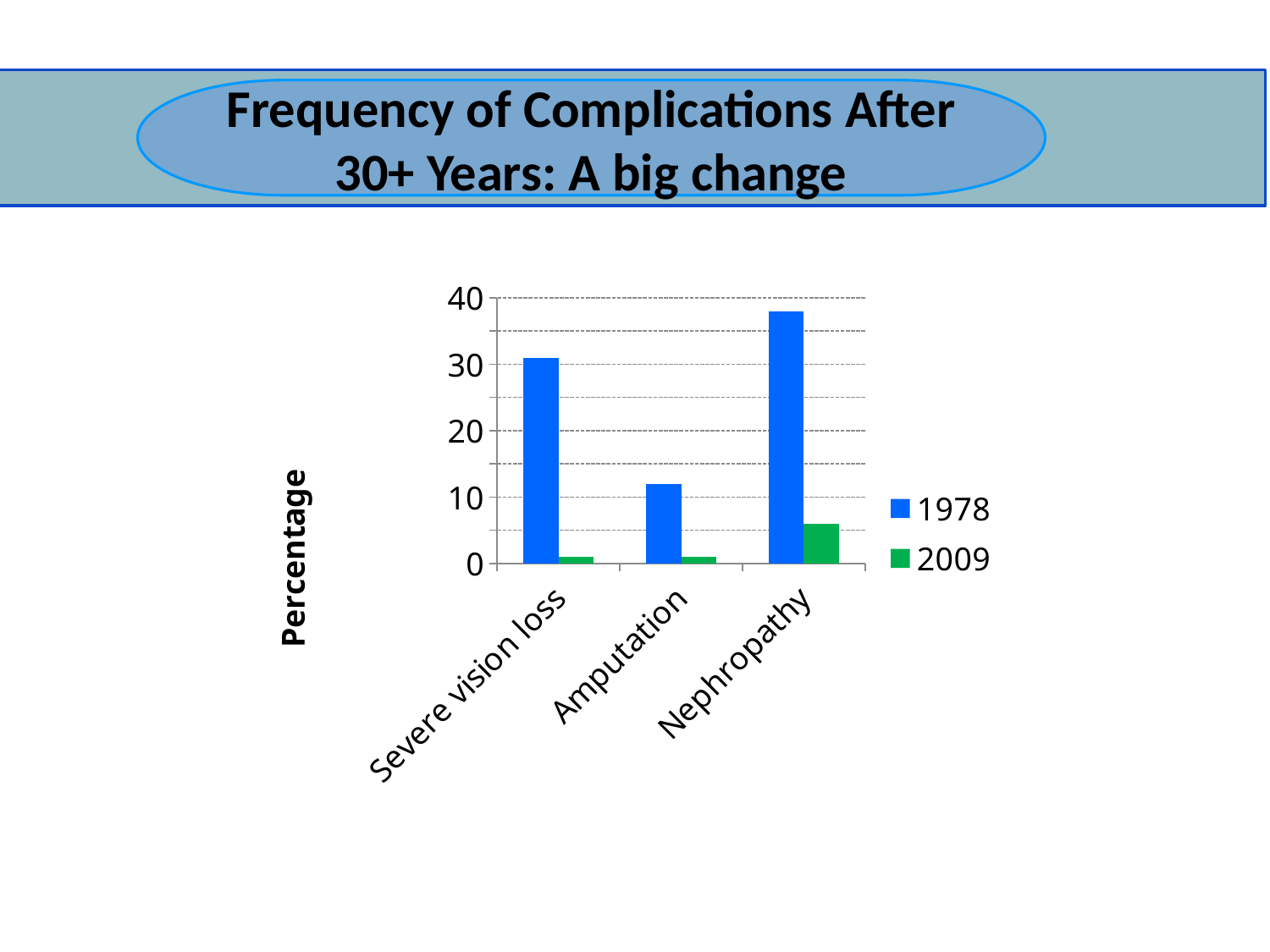
What is the label on the vertical axis? Percentage Which category has the lowest value for 1978? Amputation How many categories are shown on the x axis? 3 Which colour represents the 2009 series in the legend? green For Nephropathy, which series has the larger value, 1978 or 2009? 1978 Which category has the highest value for 2009? Nephropathy How many series does the legend list? 2 Which category has the highest value for 1978? Nephropathy What kind of chart is shown on the slide? bar chart Is the 1978 value for Amputation greater or less than 20? less Is the 2009 value for Nephropathy greater or less than 10? less